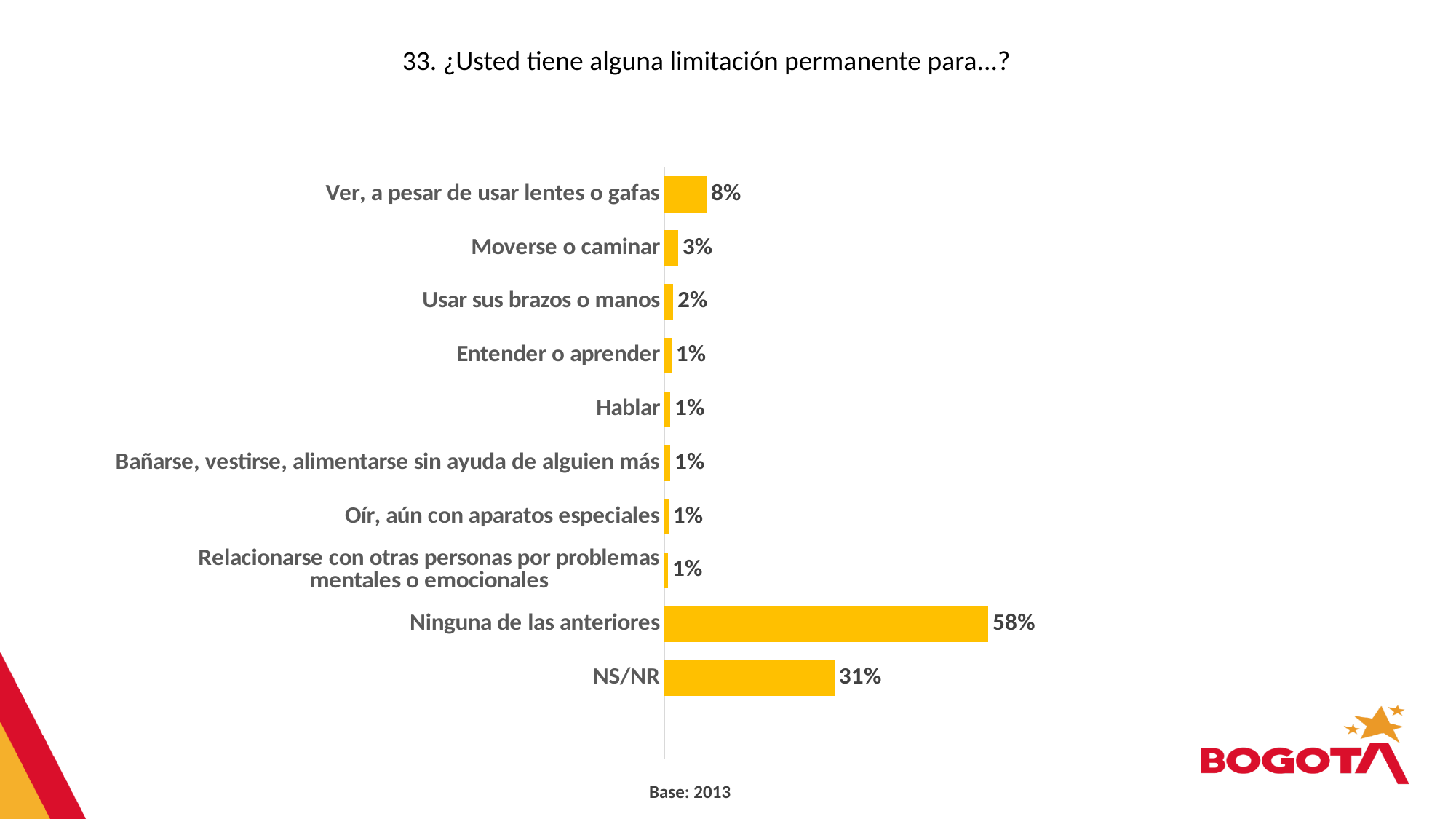
What is the value for "NS/NR"? 31% What is the difference between "Ver, a pesar de usar lentes o gafas" and "Moverse o caminar"? 5% Which is larger, the value for "Ver, a pesar de usar lentes o gafas" or the value for "Moverse o caminar"? Ver, a pesar de usar lentes o gafas How many categories are shown in the chart? 10 What base is stated below the chart? Base: 2013 What is the title of the chart? 33. ¿Usted tiene alguna limitación permanente para…? What is the value for "Ver, a pesar de usar lentes o gafas"? 8% What kind of chart is shown on the slide? Bar chart What is the difference between "Ninguna de las anteriores" and "NS/NR"? 27% What is the value for "Usar sus brazos o manos"? 2% Which category has the highest value? Ninguna de las anteriores What is the value for "Moverse o caminar"? 3%